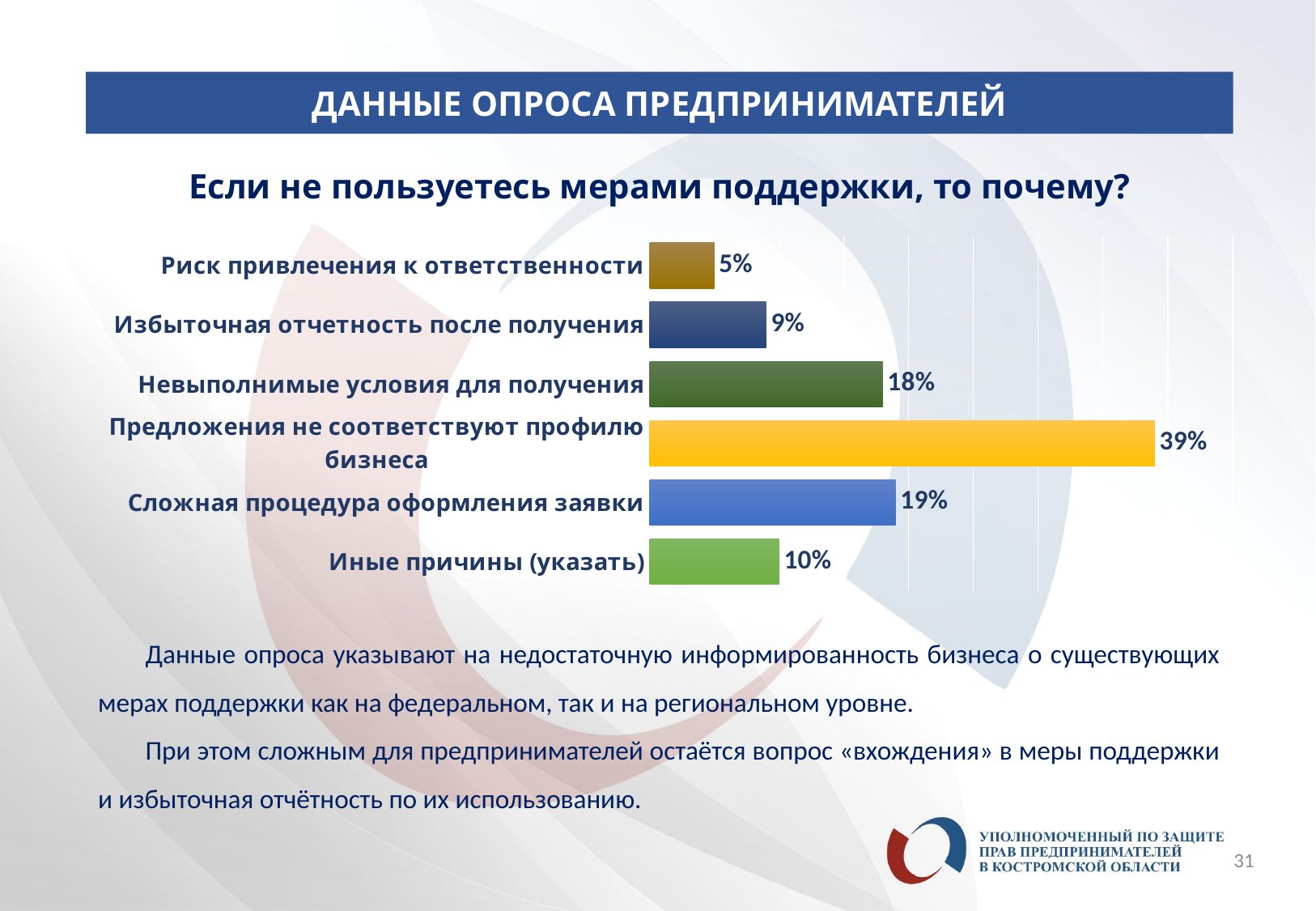
How many categories are shown in the chart? 6 What value is shown for "Риск привлечения к ответственности"? 5% What percentage is shown for "Предложения не соответствуют профилю бизнеса"? 39% What is the title of the chart? Если не пользуетесь мерами поддержки, то почему? What is the difference between "Невыполнимые условия для получения" and "Избыточная отчетность после получения"? 9% What type of chart is shown on the slide? Bar chart What percentage is shown for "Сложная процедура оформления заявки"? 19% What is the difference between "Предложения не соответствуют профилю бизнеса" and "Сложная процедура оформления заявки"? 20% Which category has the highest value? Предложения не соответствуют профилю бизнеса Which is larger: "Невыполнимые условия для получения" or "Иные причины (указать)"? Невыполнимые условия для получения Which category has the lowest value? Риск привлечения к ответственности What value is shown for "Иные причины (указать)"? 10%